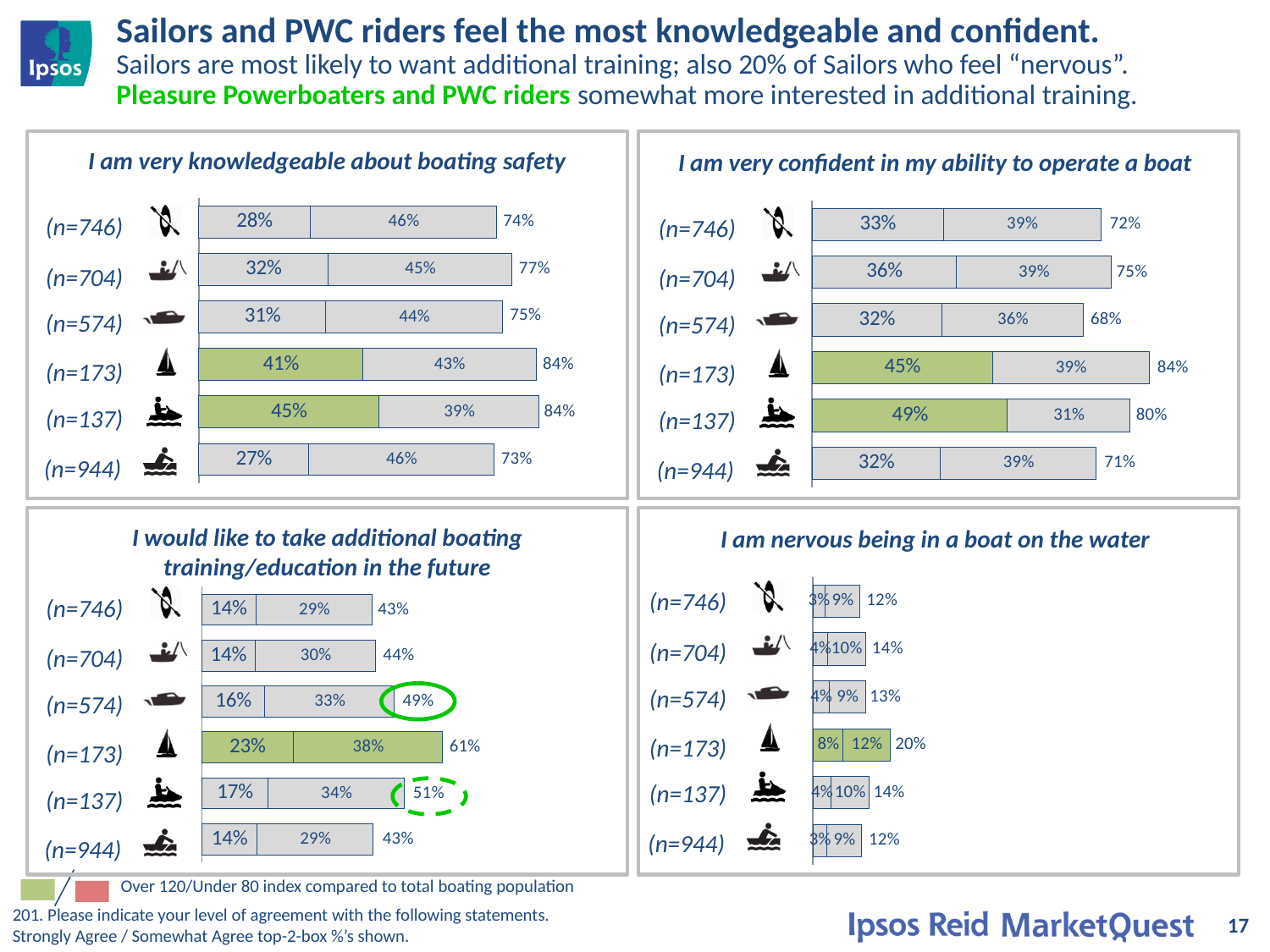
How many rows (categories) are shown in the chart 'I am nervous being in a boat on the water'? 6 In the chart 'I would like to take additional boating training/education in the future', which row has the highest total value? (n=173) What type of chart is 'I am very confident in my ability to operate a boat'? Stacked bar chart In the chart 'I would like to take additional boating training/education in the future', what is the difference between the total values for the (n=173) row and the (n=574) row? 12% In the chart 'I am very confident in my ability to operate a boat', what is the 'strongly agree' (first segment) value for the (n=137) row? 49% In the chart 'I am very knowledgeable about boating safety', what is the sum of the two segments for the (n=173) row? 84% In the chart 'I am very knowledgeable about boating safety', is the total value for the (n=704) row larger or smaller than the total for the (n=944) row? larger How many charts are shown on the slide? 4 In the chart 'I would like to take additional boating training/education in the future', what is the second segment value for the (n=137) row? 34% In the chart 'I am very knowledgeable about boating safety', what is the total (top-2-box) value for the (n=704) row? 77% In the chart 'I am nervous being in a boat on the water', what is the total value for the (n=173) row? 20% In the chart 'I am very confident in my ability to operate a boat', which row has the lowest total value? (n=574)